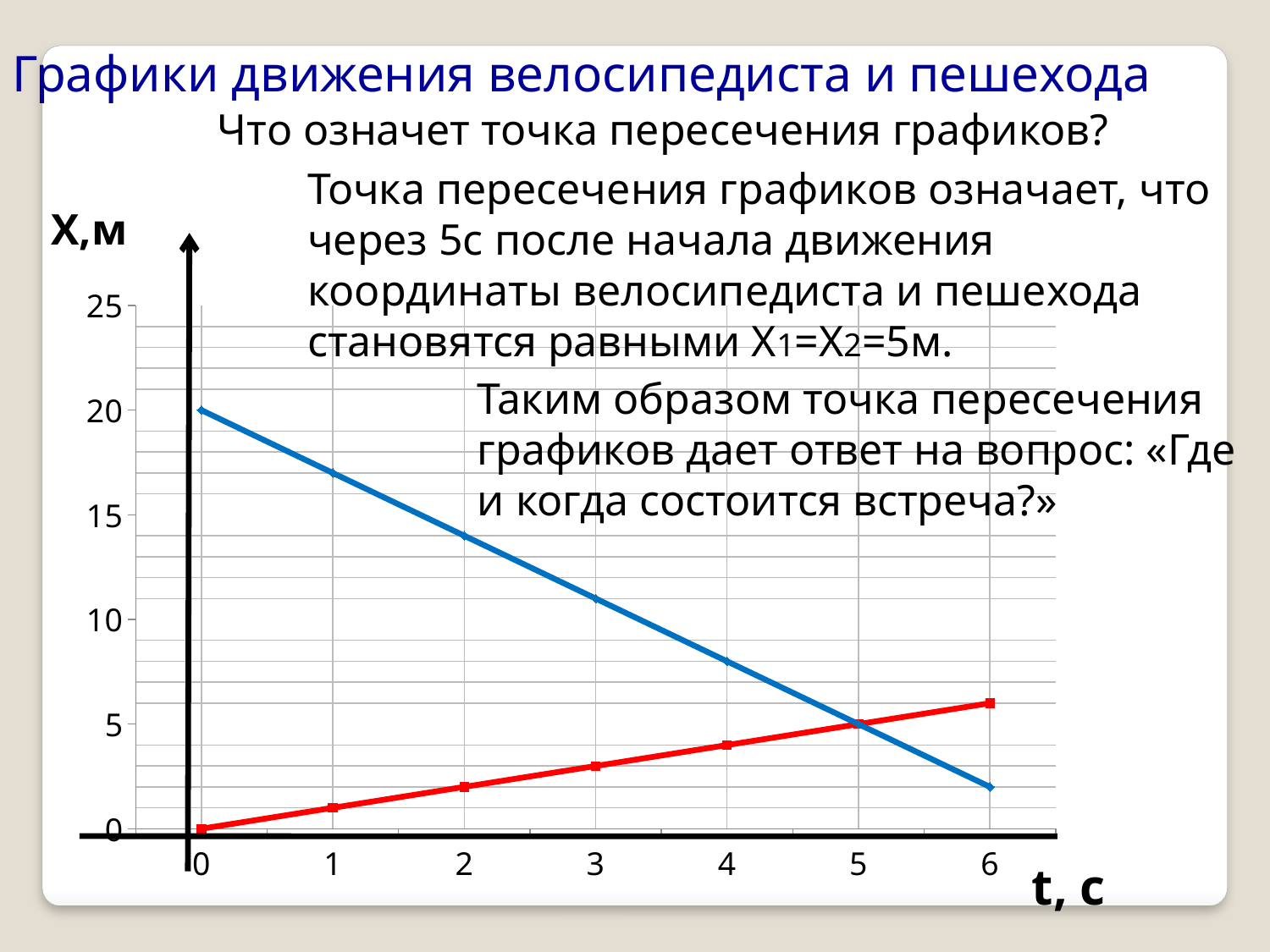
Is the value of the blue line at t = 2 greater or less than 10? greater What is the value of X at the point where the two lines intersect? 5 At what value of t do the blue and red lines intersect? 5 What is the difference between the blue line and the red line at t = 0? 20 What is the label of the horizontal axis? t, c Does the red line rise or fall as t increases? rises What is the value of X for the red line at t = 0? 0 What is the value of X for the blue line at t = 0? 20 At t = 6, which line has the higher value, blue or red? red How many lines are plotted on the chart? 2 What kind of chart is shown on the slide? line chart Does the blue line rise or fall as t increases? falls